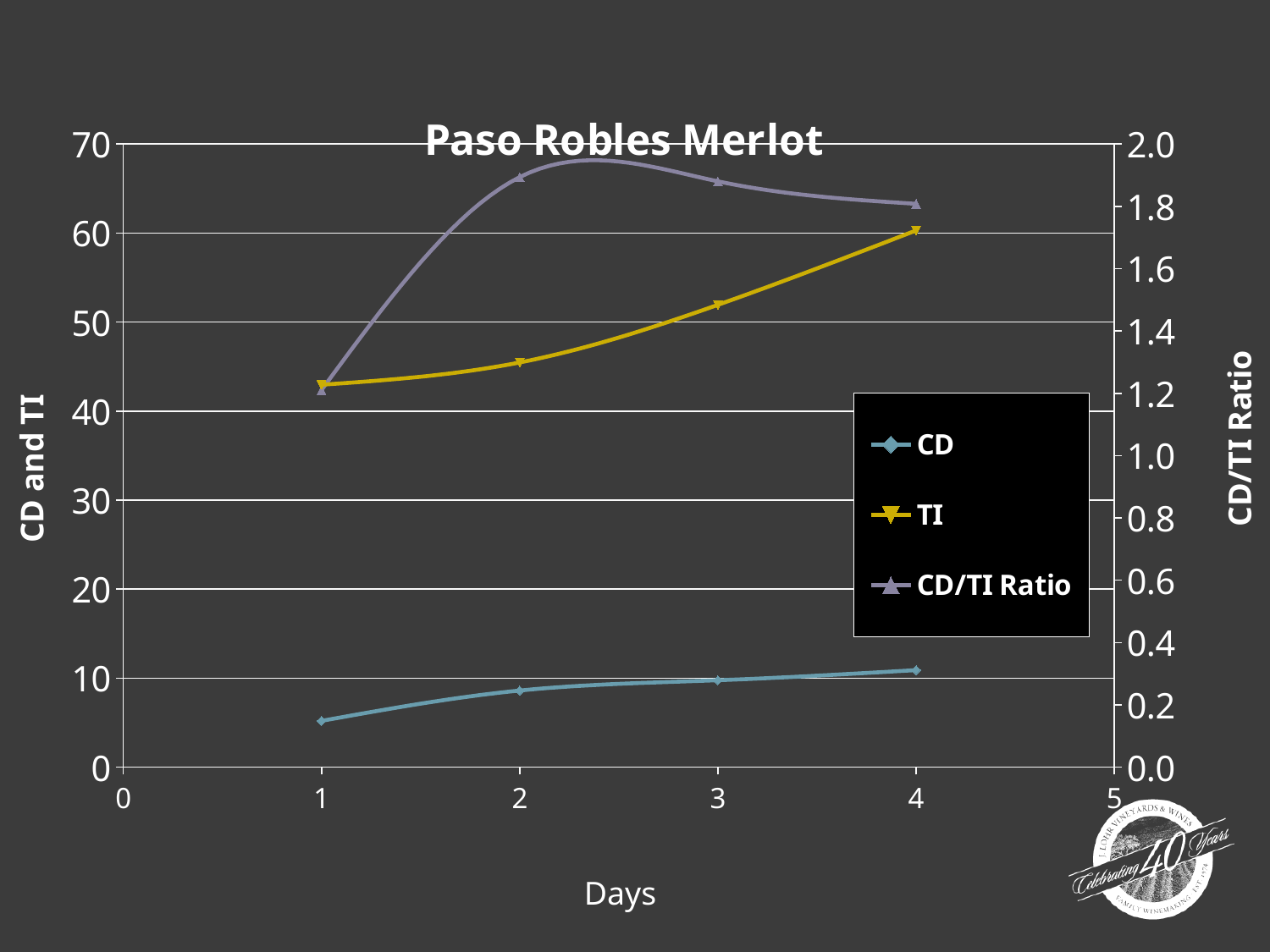
What kind of chart is shown on the slide? line chart Is the TI value on day 4 greater or less than 50? greater What is the title of the chart? Paso Robles Merlot How many series does the legend list? 3 How many data points are plotted for the TI series? 4 Does the TI series rise or fall from day 1 to day 4? rise Does the CD series rise or fall from day 1 to day 4? rise On which day is the TI value highest? 4 Is the CD value on day 1 greater or less than 10? less On which day is the CD/TI Ratio lowest? 1 On which day is the CD value lowest? 1 Is the CD/TI Ratio on day 1 greater or less than 1.4? less